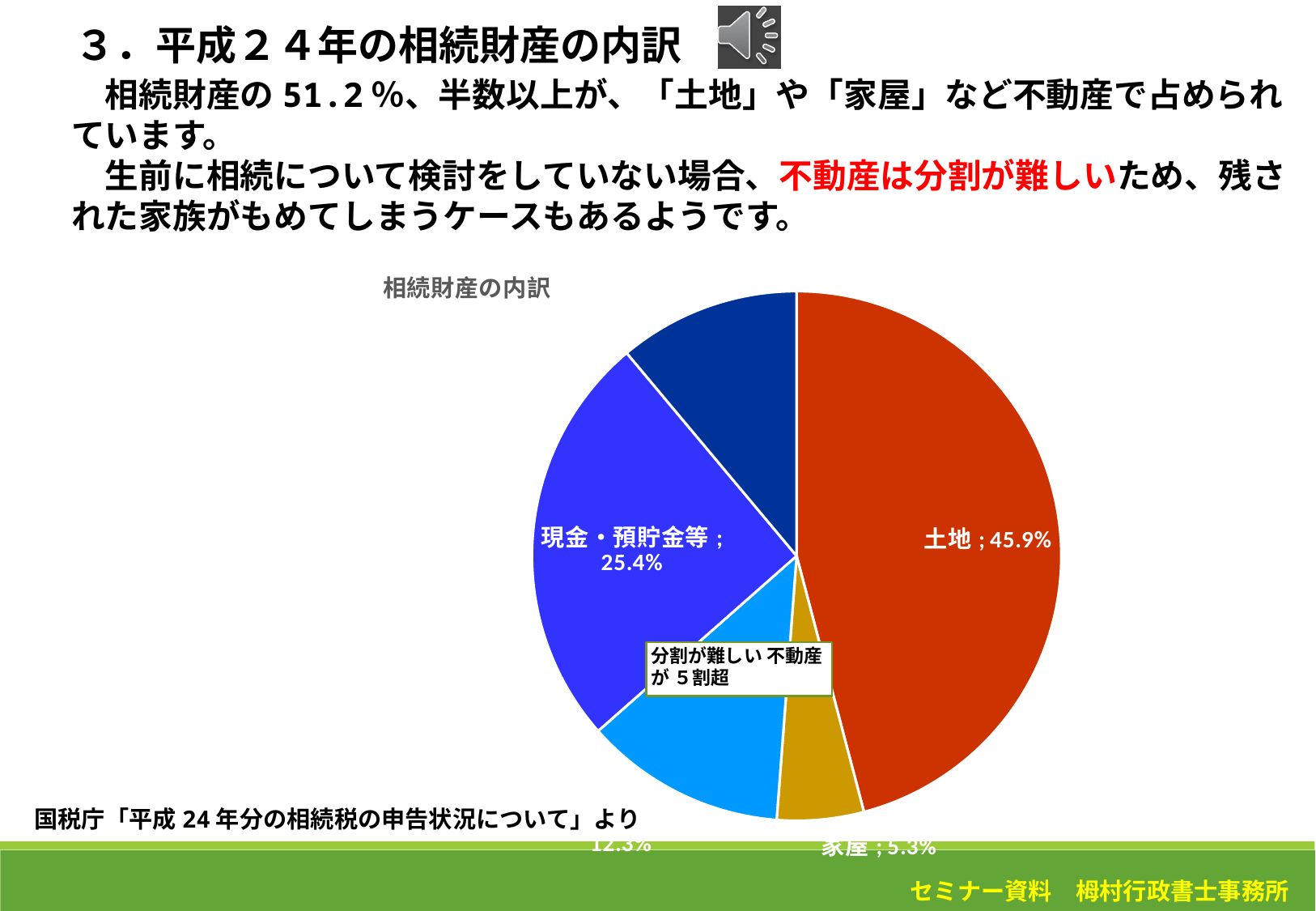
What share of the pie does 土地 account for? 45.9% What kind of chart is shown on the slide? pie chart What does the text box placed over the chart say? 分割が難しい不動産が５割超 Which category has the largest slice of the pie? 土地 What is the title of the chart? 相続財産の内訳 What is the combined share of 土地 and 家屋? 51.2% Which category has the smallest slice of the pie? 家屋 What share of the pie does 現金・預貯金等 account for? 25.4% How many percentage points larger is the 土地 slice than the 現金・預貯金等 slice? 20.5 How many slices does the pie chart have? 5 Which is larger, the slice for 土地 or the slice for 現金・預貯金等? 土地 What share of the pie does 家屋 account for? 5.3%